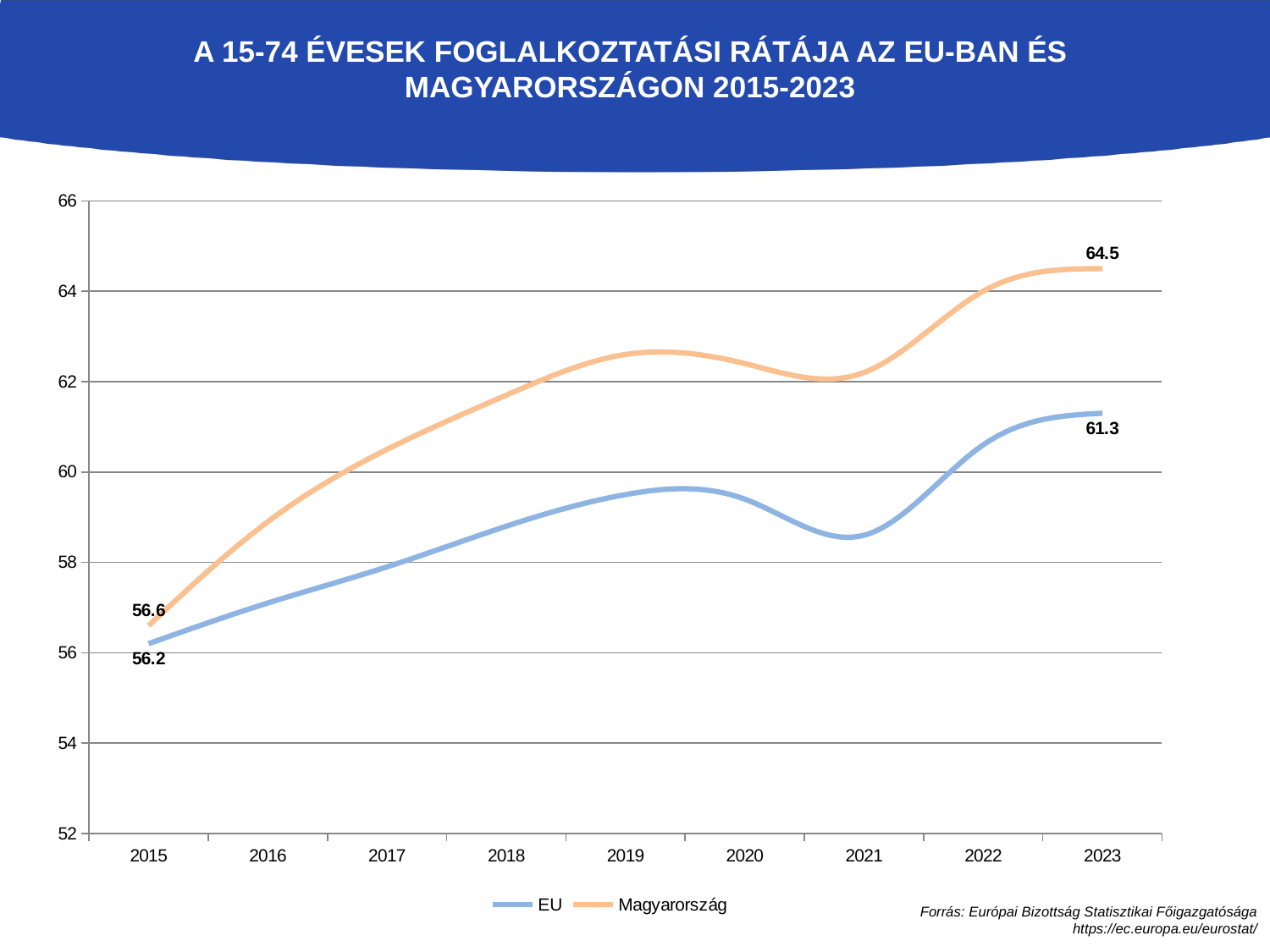
What is the employment rate for Magyarország in 2015? 56.6 Is the value for the EU in 2021 greater or less than 60? less By how much did the EU employment rate change between 2015 and 2023? 5.1 What is the employment rate for the EU in 2023? 61.3 What is the employment rate for Magyarország in 2023? 64.5 Which series has the higher value in 2023, EU or Magyarország? Magyarország What kind of chart is shown on the slide? Line chart Is the value for Magyarország in 2019 greater or less than 62? greater How many series does the legend list? 2 What is the employment rate for the EU in 2015? 56.2 What is the difference between the Magyarország and EU values in 2023? 3.2 How many years are shown on the x axis? 9